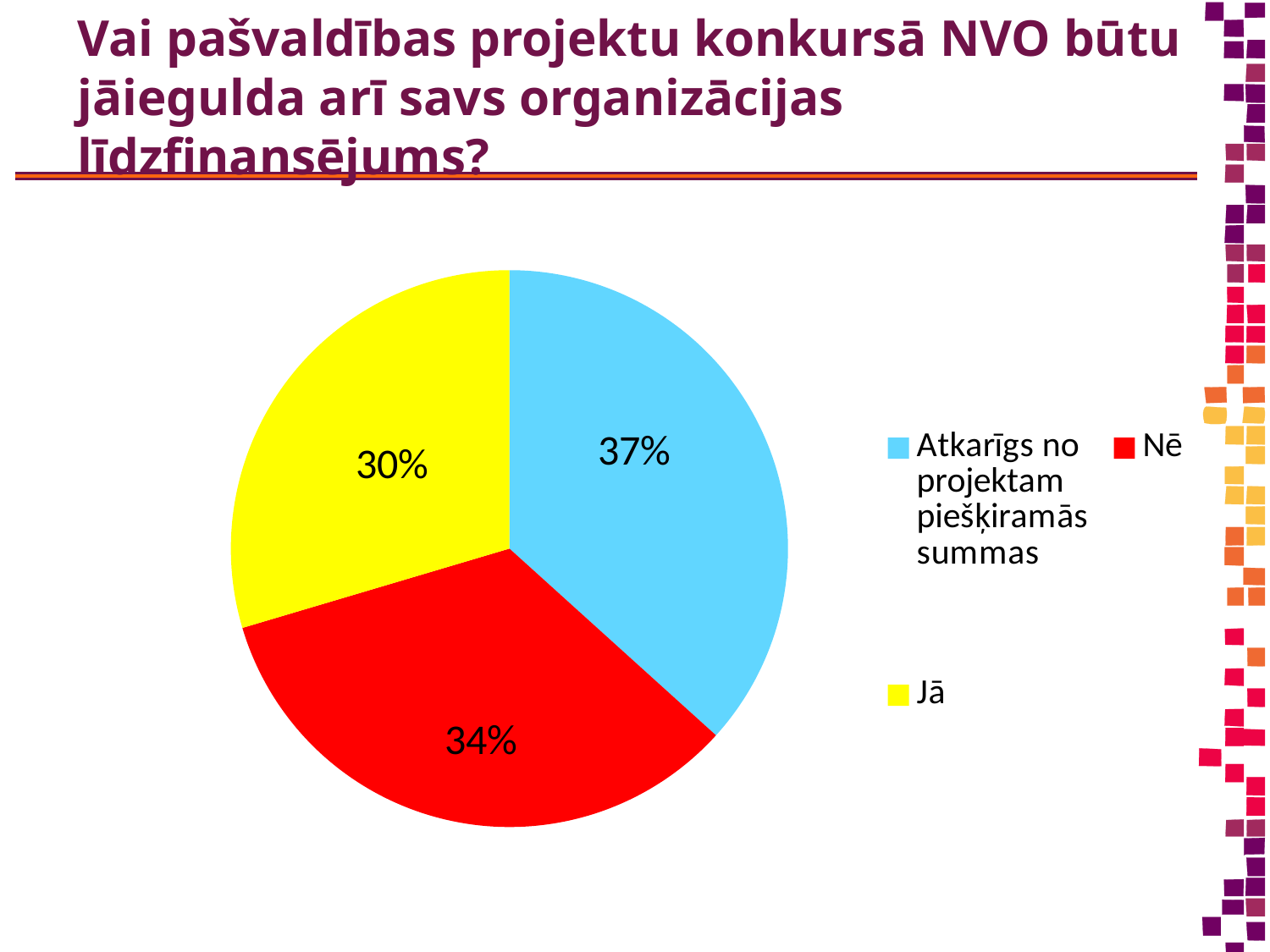
What is the difference in percentage points between the "Atkarīgs no projektam piešķiramās summas" slice and the "Nē" slice? 3 How many slices does the pie chart have? 3 What share of the pie is labelled "Jā"? 30% What is the difference in percentage points between the "Nē" slice and the "Jā" slice? 4 Which slice of the pie is the largest? Atkarīgs no projektam piešķiramās summas What share of the pie is labelled "Nē"? 34% Which slice of the pie is the smallest? Jā Which is larger, the "Nē" slice or the "Jā" slice? Nē What kind of chart is shown on the slide? pie chart Which legend entry is shown in red? Nē What colour is the "Jā" slice? yellow What share of the pie is labelled "Atkarīgs no projektam piešķiramās summas"? 37%